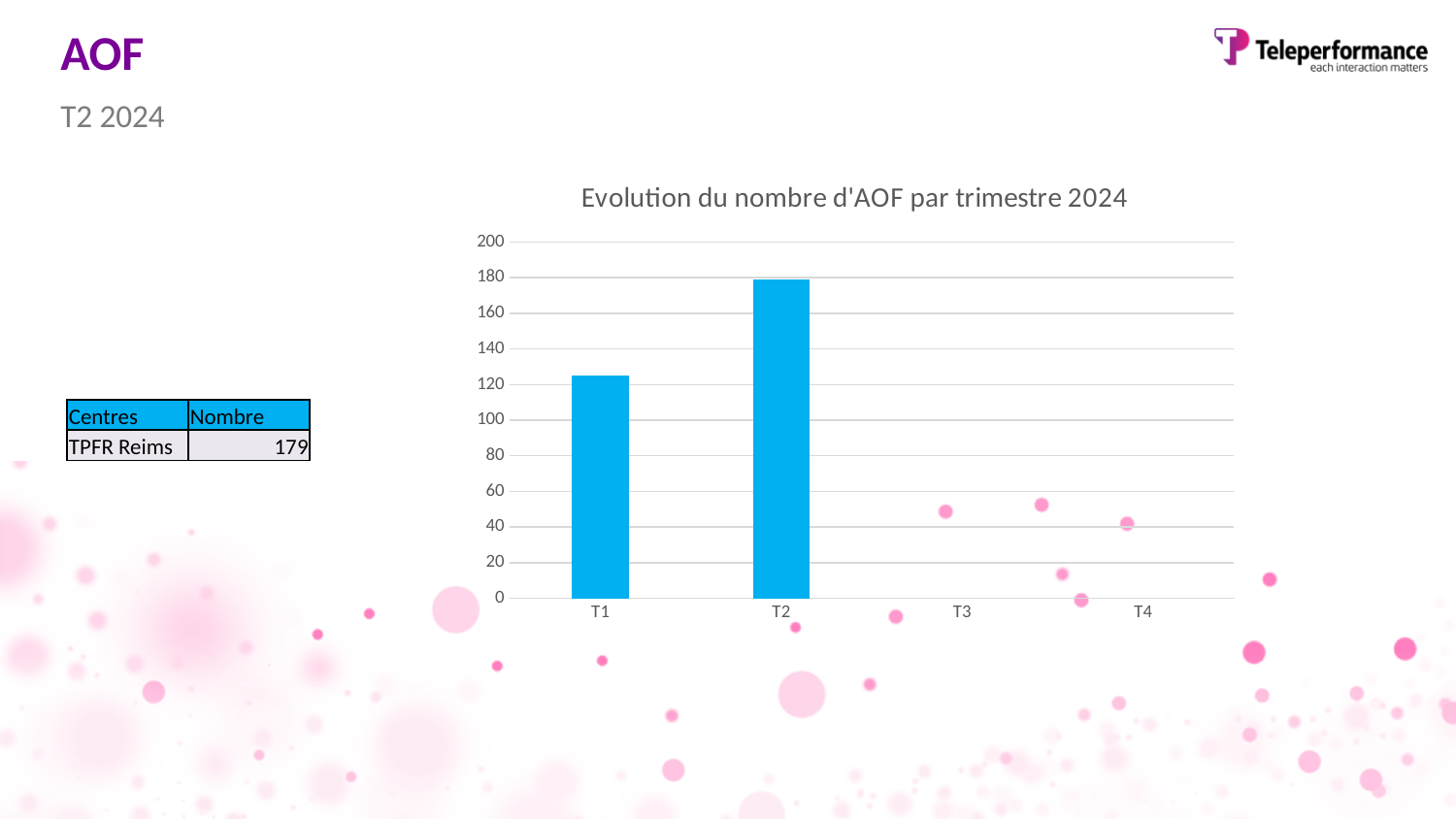
What is the title of the chart? Evolution du nombre d'AOF par trimestre 2024 Is the value for T2 greater or less than 200? less How many quarter categories are shown on the x axis of the chart? 4 Is the value for T1 greater or less than 100? greater Which quarters on the x axis have no bar plotted? T3 and T4 What is the maximum value shown on the y axis of the chart? 200 Is the value for T2 greater or less than 160? greater Which quarter has the highest bar in the chart? T2 What kind of chart is shown on the slide? bar chart Which is larger, the value for T1 or the value for T2? T2 Does the value rise or fall from T1 to T2? rise